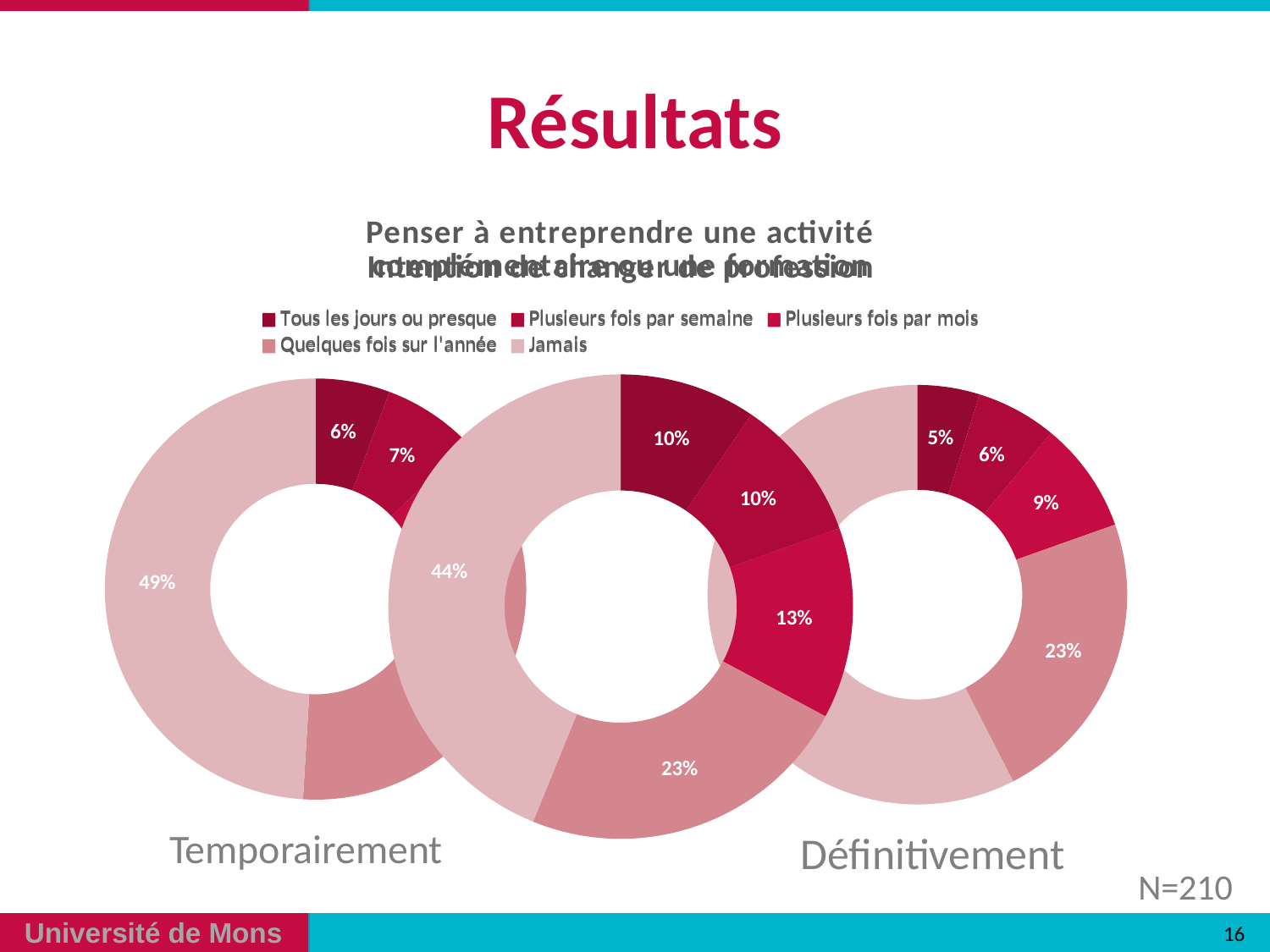
In the right donut chart labelled "Définitivement", what percentage is shown for "Quelques fois sur l'année"? 23% How many categories does the legend list for the donut charts? 5 What type of chart is used on this slide? Donut (pie) chart In the middle donut chart, what percentage is shown for "Plusieurs fois par mois"? 13% In the left donut chart labelled "Temporairement", what percentage is shown for "Plusieurs fois par semaine"? 7% In the left donut chart labelled "Temporairement", what percentage is shown for "Tous les jours ou presque"? 6% In the left donut chart labelled "Temporairement", what percentage is shown for "Jamais"? 49% In the middle donut chart, what is the difference in percentage points between "Jamais" and "Quelques fois sur l'année"? 21 percentage points In the middle donut chart, which category has the largest share? Jamais In the right donut chart labelled "Définitivement", what percentage is shown for "Plusieurs fois par mois"? 9% In the middle donut chart, what percentage is shown for "Quelques fois sur l'année"? 23% In the middle donut chart, what percentage is shown for "Jamais"? 44%